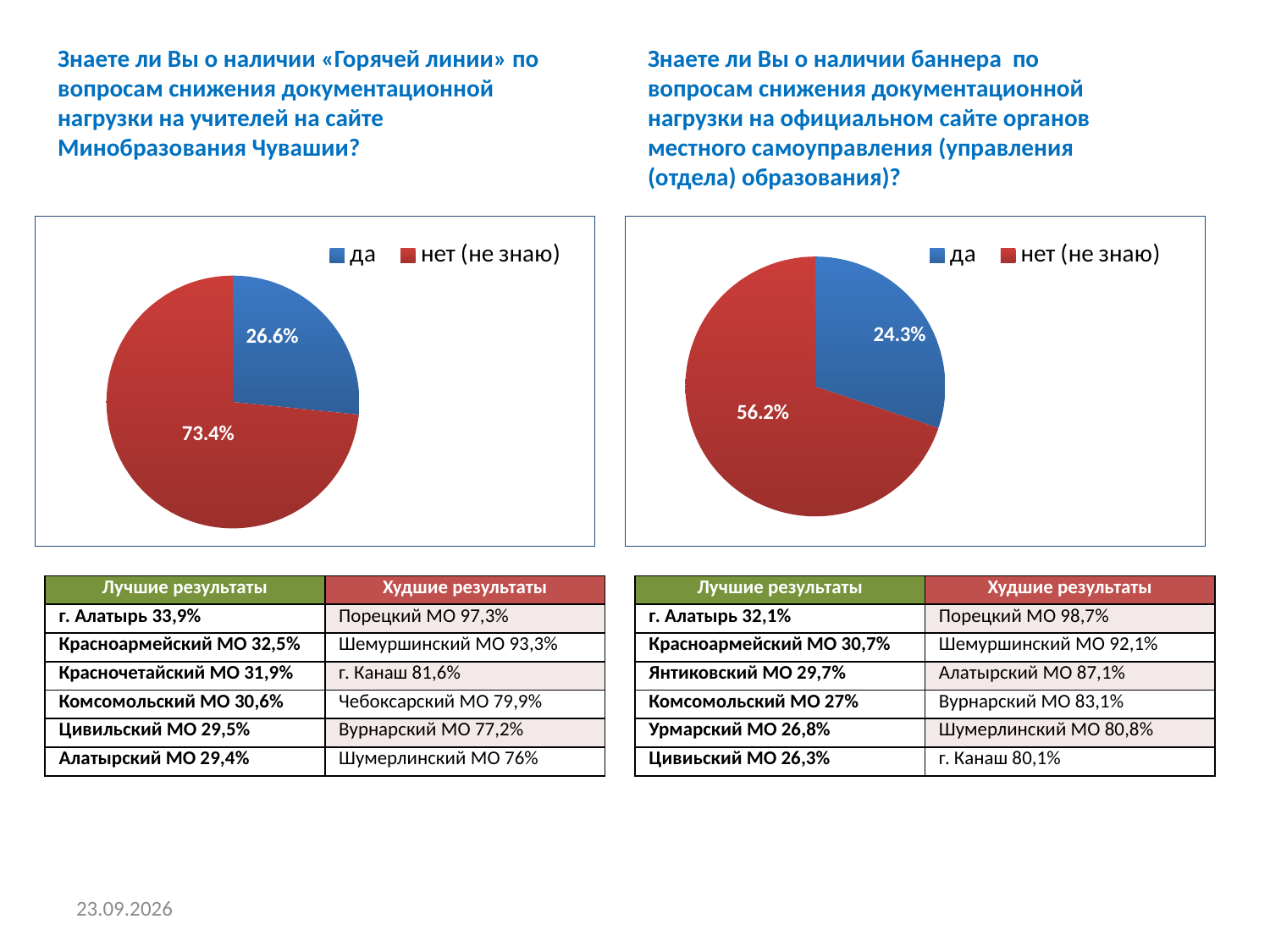
In the right pie chart, what share of respondents answered "да"? 24.3% In the left pie chart, what share of respondents answered "да"? 26.6% What type of chart is shown on the left side of the slide? pie chart In the left pie chart, what colour is the "да" slice? blue In the left pie chart, what is the value for "нет (не знаю)"? 73.4% In the right pie chart, which category has the smallest slice? да In the right pie chart, what is the difference between the "нет (не знаю)" and "да" values? 31.9% Is the "да" value larger in the left pie chart or in the right pie chart? left pie chart In the right pie chart, what is the value for "нет (не знаю)"? 56.2% In the left pie chart, what is the difference between the "нет (не знаю)" and "да" values? 46.8% How many categories does the legend of the right pie chart list? 2 In the left pie chart, which category has the largest slice? нет (не знаю)